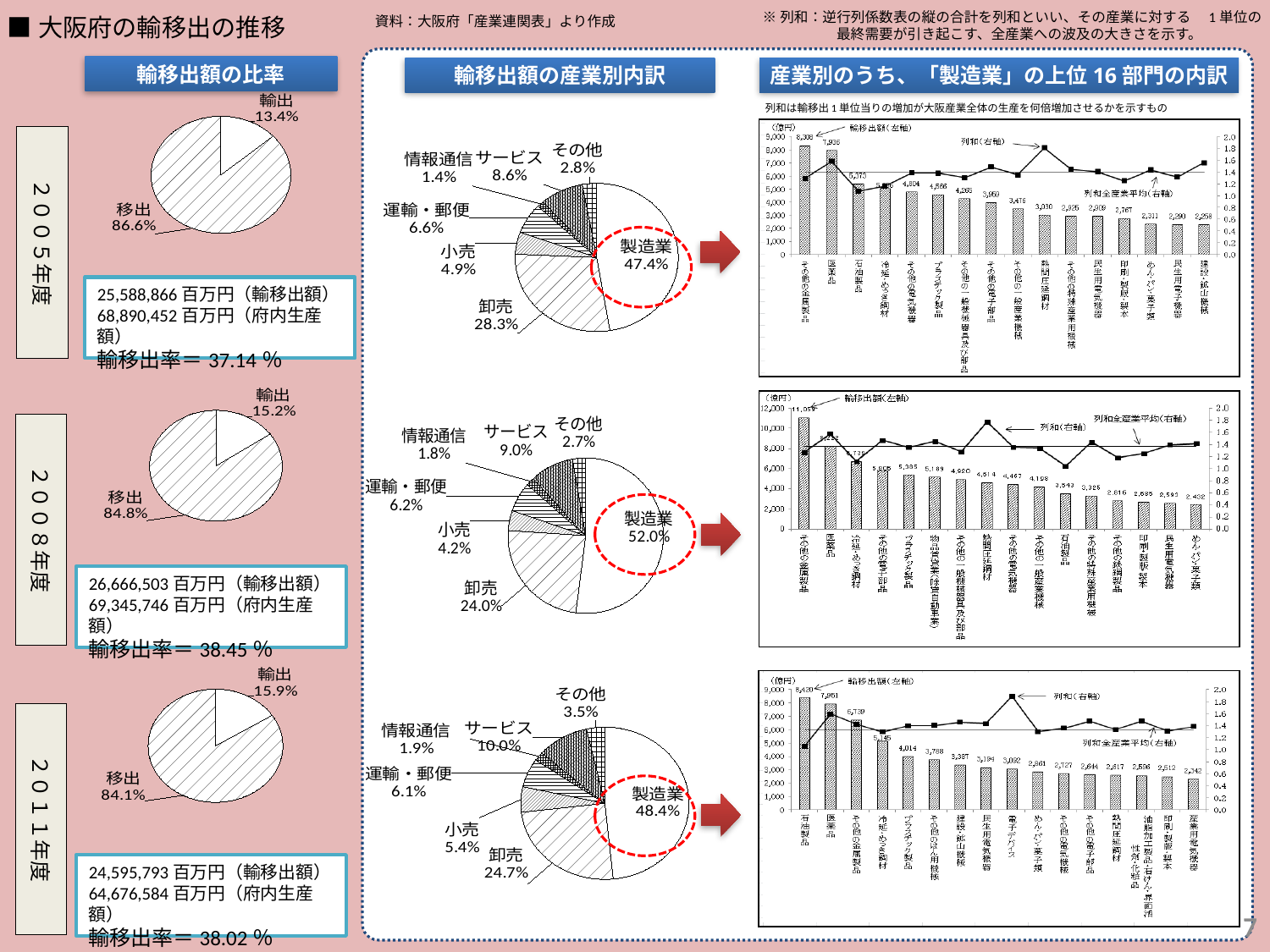
In the 2005年度 pie chart under 輸移出額の産業別内訳, what share is 卸売? 28.3% In the 2011年度 pie chart under 輸移出額の比率, what share is 移出? 84.1% How many categories does each pie chart under 輸移出額の産業別内訳 show? 7 In the 2008年度 pie chart under 輸移出額の産業別内訳, what share is 製造業? 52.0% In the bottom chart under 産業別のうち、「製造業」の上位16部門の内訳 (2011年度), what is the value of the bar for 石油製品? 8,420 In the 2005年度 pie chart under 輸移出額の比率, what share is 輸出? 13.4% In the top chart under 産業別のうち、「製造業」の上位16部門の内訳 (2005年度), what is the value of the bar for その他の金属製品? 8,308 In the 2011年度 pie chart under 輸移出額の産業別内訳, which category has the largest share? 製造業 In the 2005年度 pie chart under 輸移出額の産業別内訳, which category has the smallest share? 情報通信 In the 2008年度 pie chart under 輸移出額の産業別内訳, which is larger, サービス or 運輸・郵便? サービス In the 2011年度 pie chart under 輸移出額の産業別内訳, what is the difference between the 製造業 share and the 卸売 share? 23.7% What type of chart is used for the 輸移出額の比率 section on the left of the slide? Pie chart